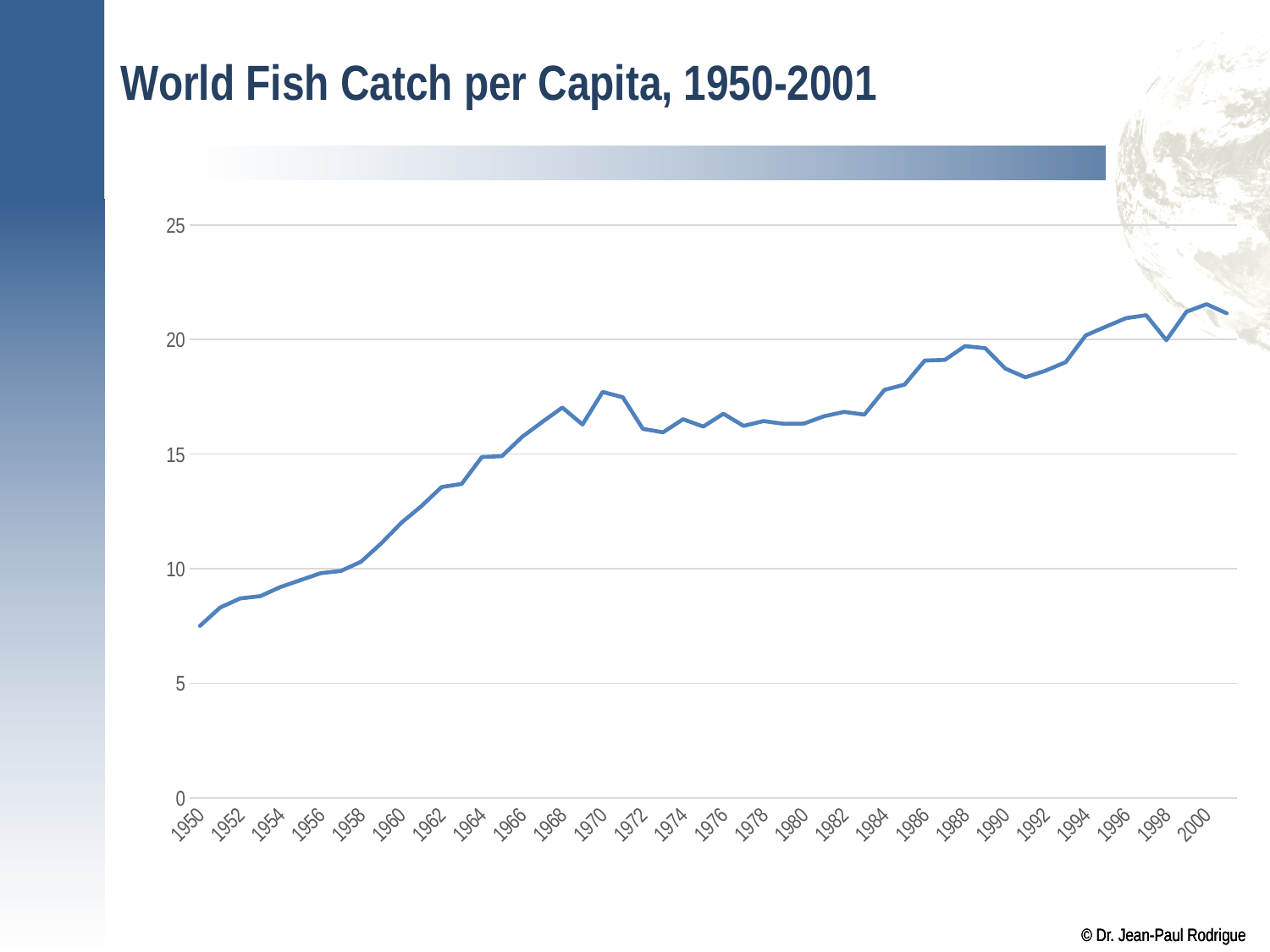
Is the value for 1970 greater or less than 15? greater Which year has the lowest value on the chart? 1950 Is the value for 1960 greater or less than 10? greater Which is larger, the value for 1970 or the value for 1972? 1970 Overall, do the values rise or fall from 1950 to 2001? rise Is the value for 1950 greater or less than 10? less What kind of chart is shown on the slide? line chart What is the highest value shown on the vertical axis? 25 What is the title of the chart? World Fish Catch per Capita, 1950-2001